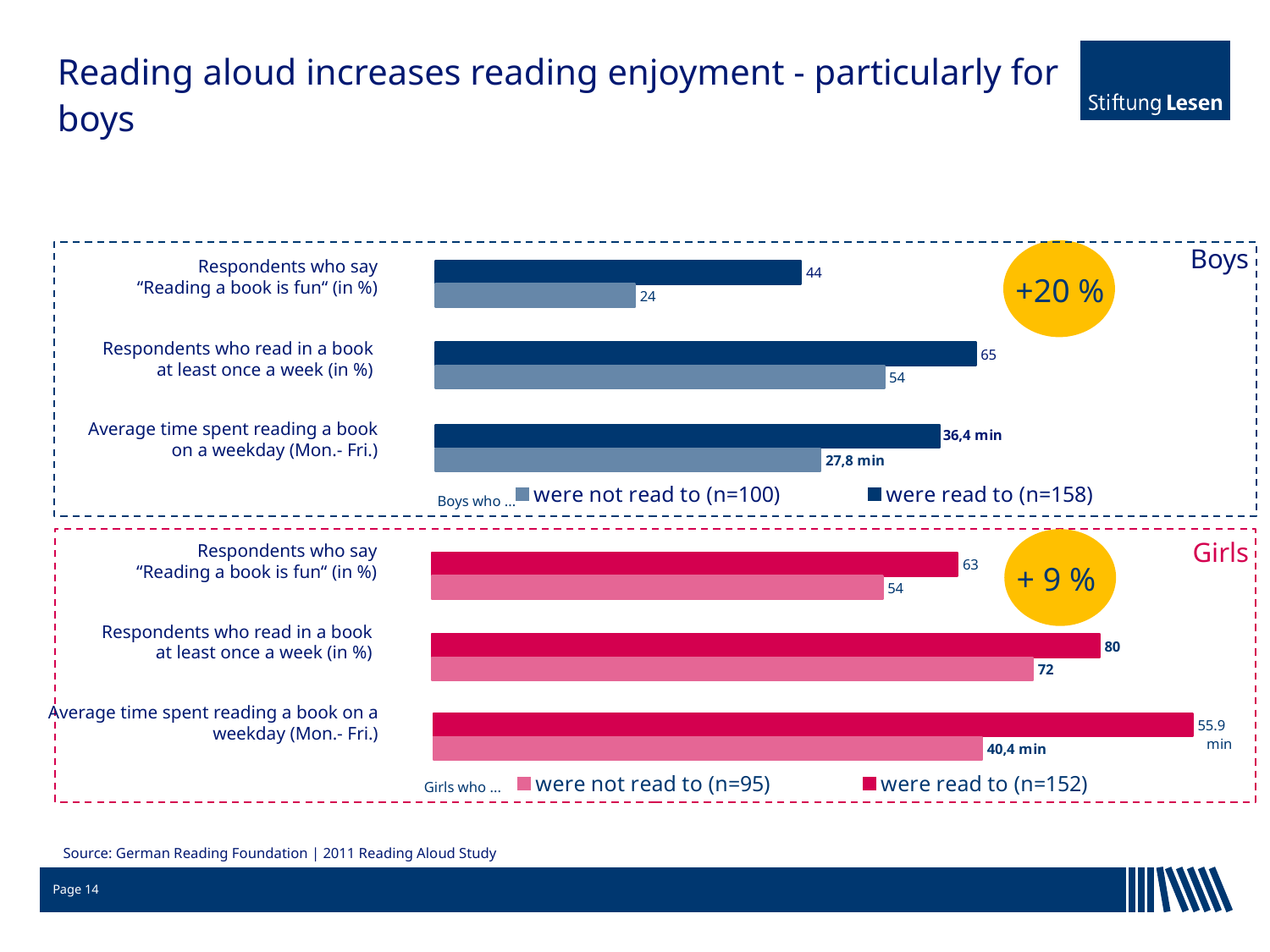
How many categories are shown in the Girls chart? 3 In the Boys chart, what is the value for respondents who say "Reading a book is fun" among boys who were read to? 44 In the Boys chart, what is the value for respondents who say "Reading a book is fun" among boys who were not read to? 24 In the Girls chart, what is the value for respondents who read in a book at least once a week among girls who were not read to? 72 In the Girls chart, which is larger for respondents who read in a book at least once a week: girls who were read to or girls who were not read to? were read to In the Girls chart, what is the sample size (n) for girls who were read to, as shown in the legend? 152 How many series does the legend of the Boys chart list? 2 In the Girls chart, what is the difference between girls who were read to and girls who were not read to for respondents who say "Reading a book is fun"? 9 In the Boys chart, what is the difference between boys who were read to and boys who were not read to for respondents who read in a book at least once a week? 11 In the Girls chart, what is the average time spent reading a book on a weekday for girls who were read to? 55.9 min In the Boys chart, what is the average time spent reading a book on a weekday for boys who were read to? 36,4 min What kind of chart is the Boys chart? bar chart